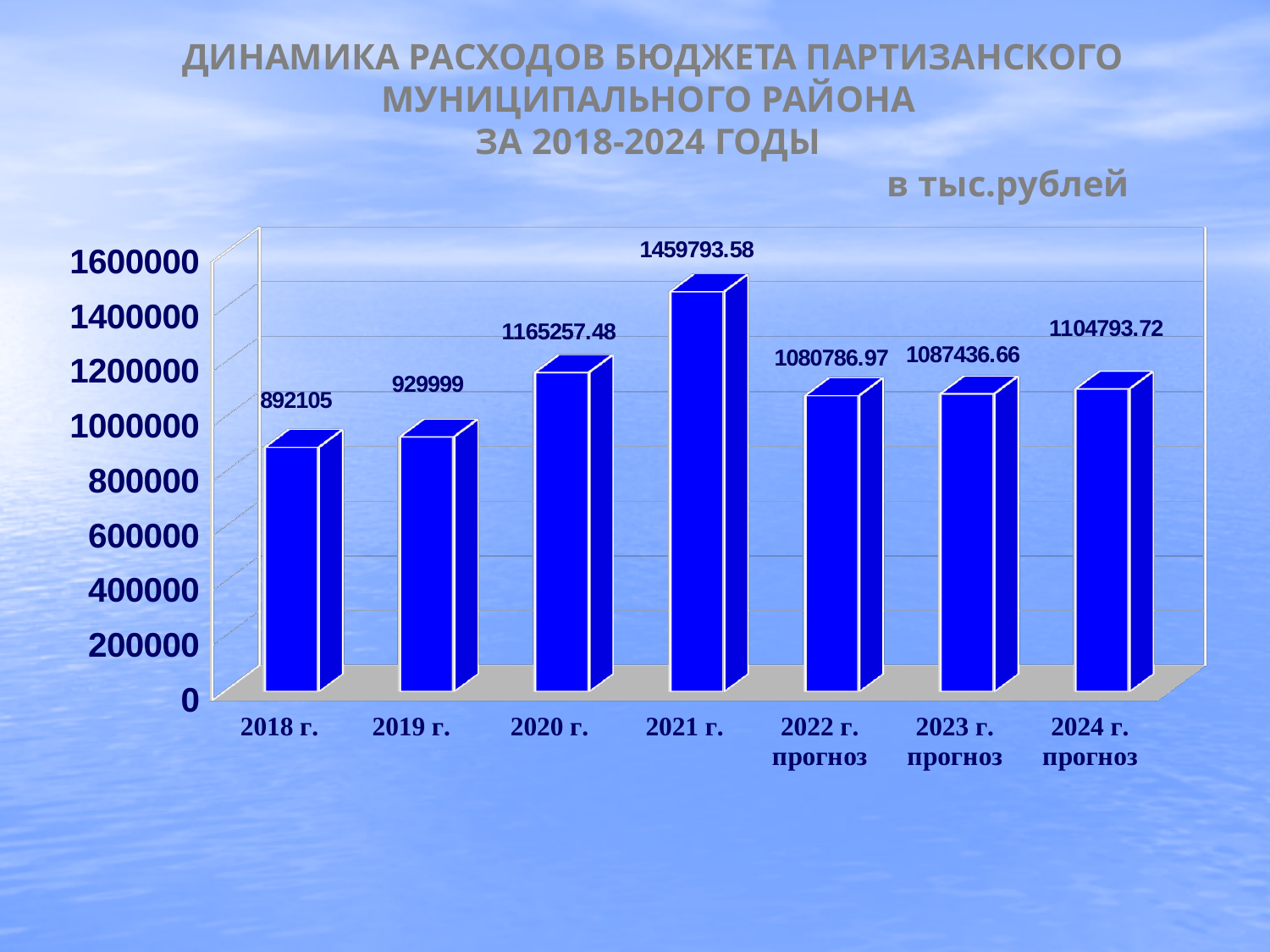
Which year has the lowest value? 2018 г. What is the difference between the values for 2019 г. and 2018 г.? 37894 Do the values rise or fall from 2018 г. to 2021 г.? rise Which is larger, the value for 2020 г. or the value for 2022 г. прогноз? 2020 г. How many years are shown on the x axis? 7 What is the difference between the values for 2021 г. and 2018 г.? 567688.58 What is the value for 2018 г.? 892105 What kind of chart is shown on the slide? bar chart Which year has the highest value? 2021 г. What is the value for 2024 г. прогноз? 1104793.72 What is the value for 2021 г.? 1459793.58 Is the value for 2019 г. greater or less than 1000000? less